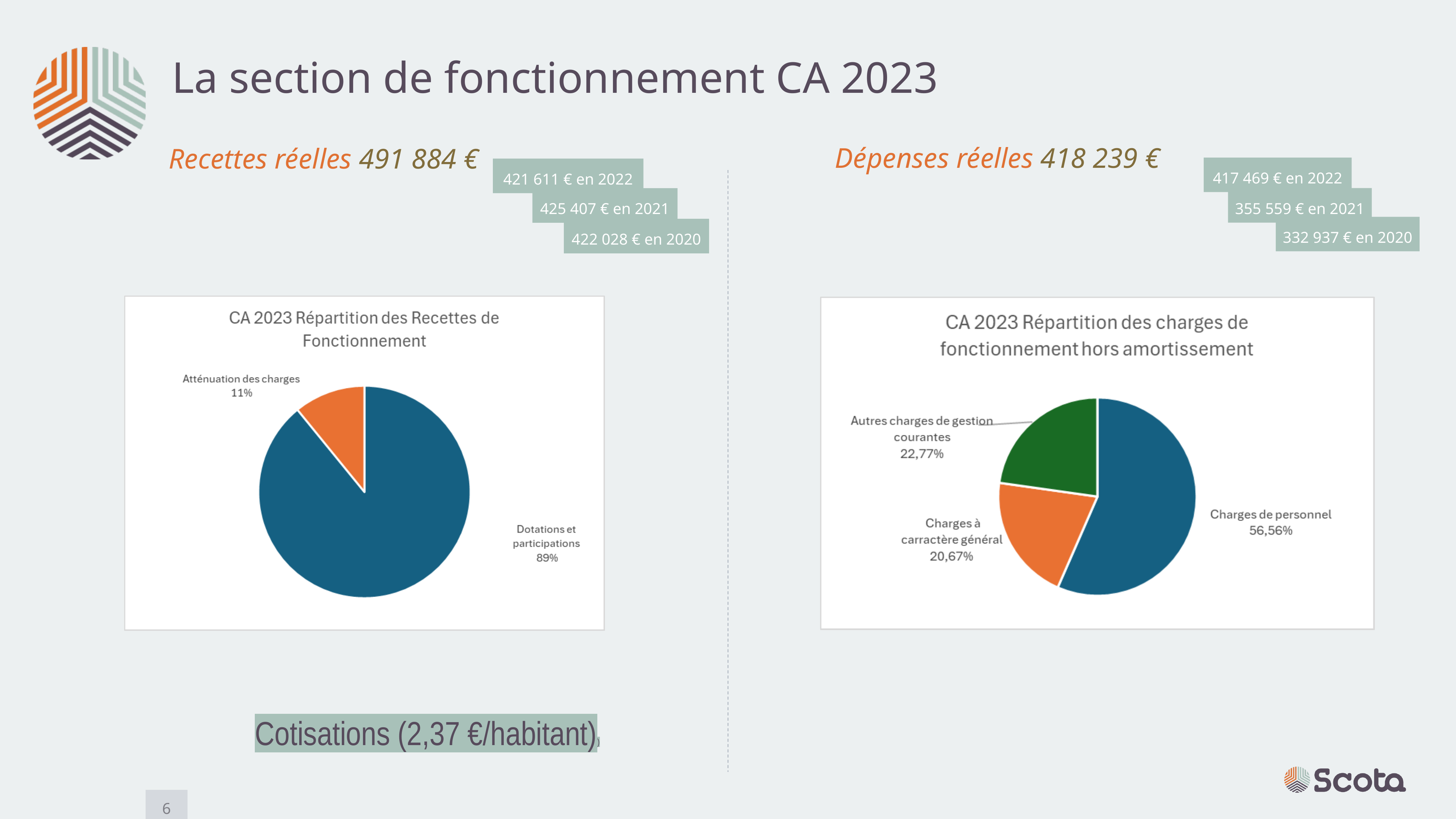
In the chart 'CA 2023 Répartition des charges de fonctionnement hors amortissement', what share does 'Autres charges de gestion courantes' have? 22,77% In the chart 'CA 2023 Répartition des Recettes de Fonctionnement', what share does 'Atténuation des charges' have? 11% In the chart 'CA 2023 Répartition des charges de fonctionnement hors amortissement', what share does 'Charges de personnel' have? 56,56% In the chart 'CA 2023 Répartition des Recettes de Fonctionnement', how many slices does the pie have? 2 In the chart 'CA 2023 Répartition des charges de fonctionnement hors amortissement', which category has the smallest slice? Charges à caractère général In the chart 'CA 2023 Répartition des Recettes de Fonctionnement', what share does 'Dotations et participations' have? 89% In the chart 'CA 2023 Répartition des charges de fonctionnement hors amortissement', what is the difference between the shares of 'Charges de personnel' and 'Charges à caractère général'? 35,89% In the chart 'CA 2023 Répartition des charges de fonctionnement hors amortissement', what colour is the 'Charges de personnel' slice? Blue What kind of chart is 'CA 2023 Répartition des Recettes de Fonctionnement'? Pie chart In the chart 'CA 2023 Répartition des Recettes de Fonctionnement', which category has the largest slice? Dotations et participations In the chart 'CA 2023 Répartition des charges de fonctionnement hors amortissement', what share does 'Charges à caractère général' have? 20,67% In the chart 'CA 2023 Répartition des charges de fonctionnement hors amortissement', how many slices does the pie have? 3